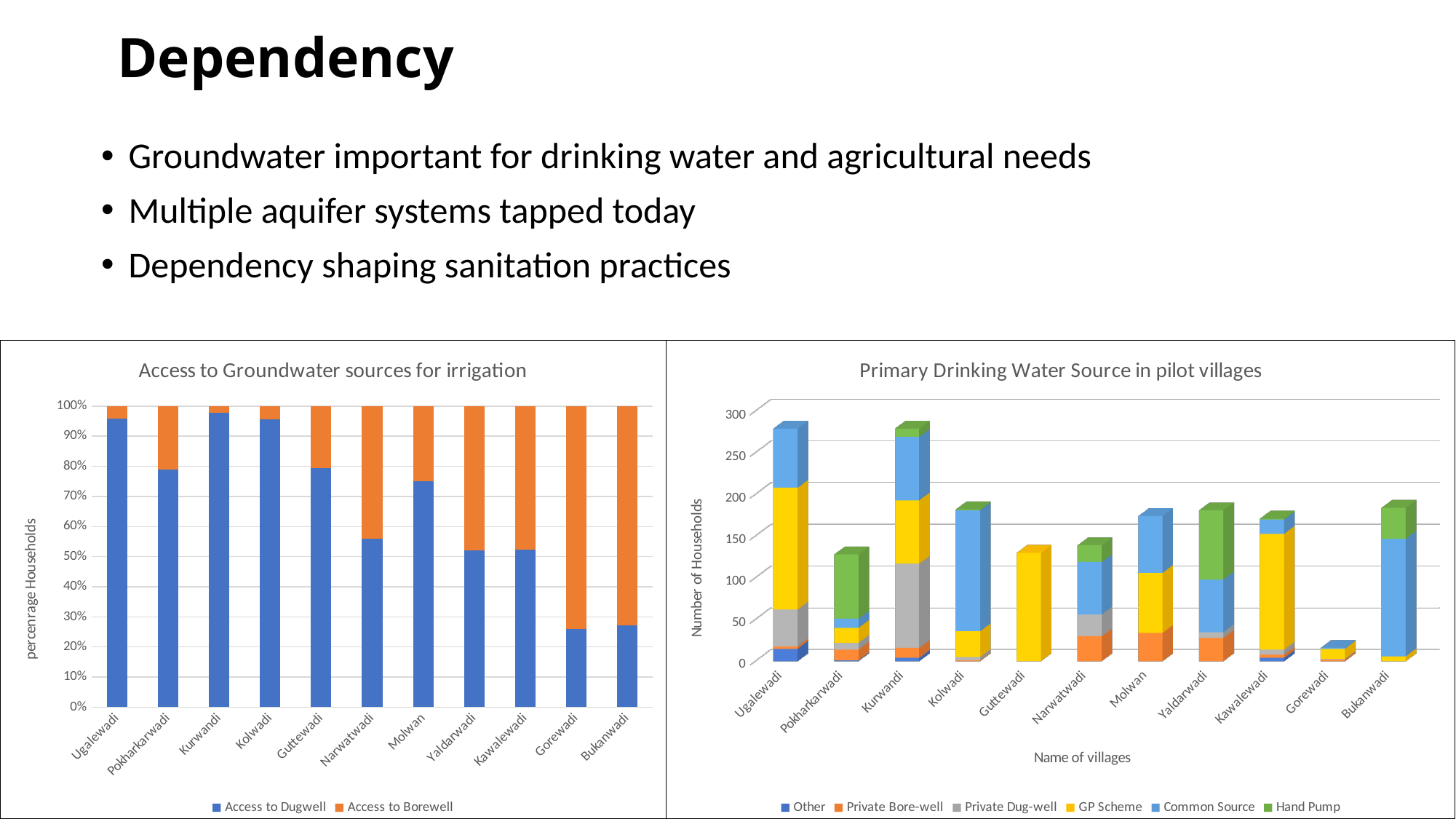
In the 'Primary Drinking Water Source in pilot villages' chart, which village has the lowest total number of households? Gorewadi In the 'Primary Drinking Water Source in pilot villages' chart, is the total for Gorewadi greater or less than 50? less In the 'Access to Groundwater sources for irrigation' chart, is the 'Access to Dugwell' value for Narwatwadi greater or less than 50%? greater How many villages are shown on the x axis of the 'Primary Drinking Water Source in pilot villages' chart? 11 What is the x-axis title of the 'Primary Drinking Water Source in pilot villages' chart? Name of villages What kind of chart is the 'Access to Groundwater sources for irrigation' chart? stacked bar chart In the 'Access to Groundwater sources for irrigation' chart, is the 'Access to Dugwell' value for Pokharkarwadi greater or less than 70%? greater In the 'Access to Groundwater sources for irrigation' chart, which village has the larger 'Access to Dugwell' share, Pokharkarwadi or Narwatwadi? Pokharkarwadi How many series does the legend of the 'Primary Drinking Water Source in pilot villages' chart list? 6 How many series does the legend of the 'Access to Groundwater sources for irrigation' chart list? 2 In the 'Primary Drinking Water Source in pilot villages' chart, which village has the larger total, Ugalewadi or Pokharkarwadi? Ugalewadi